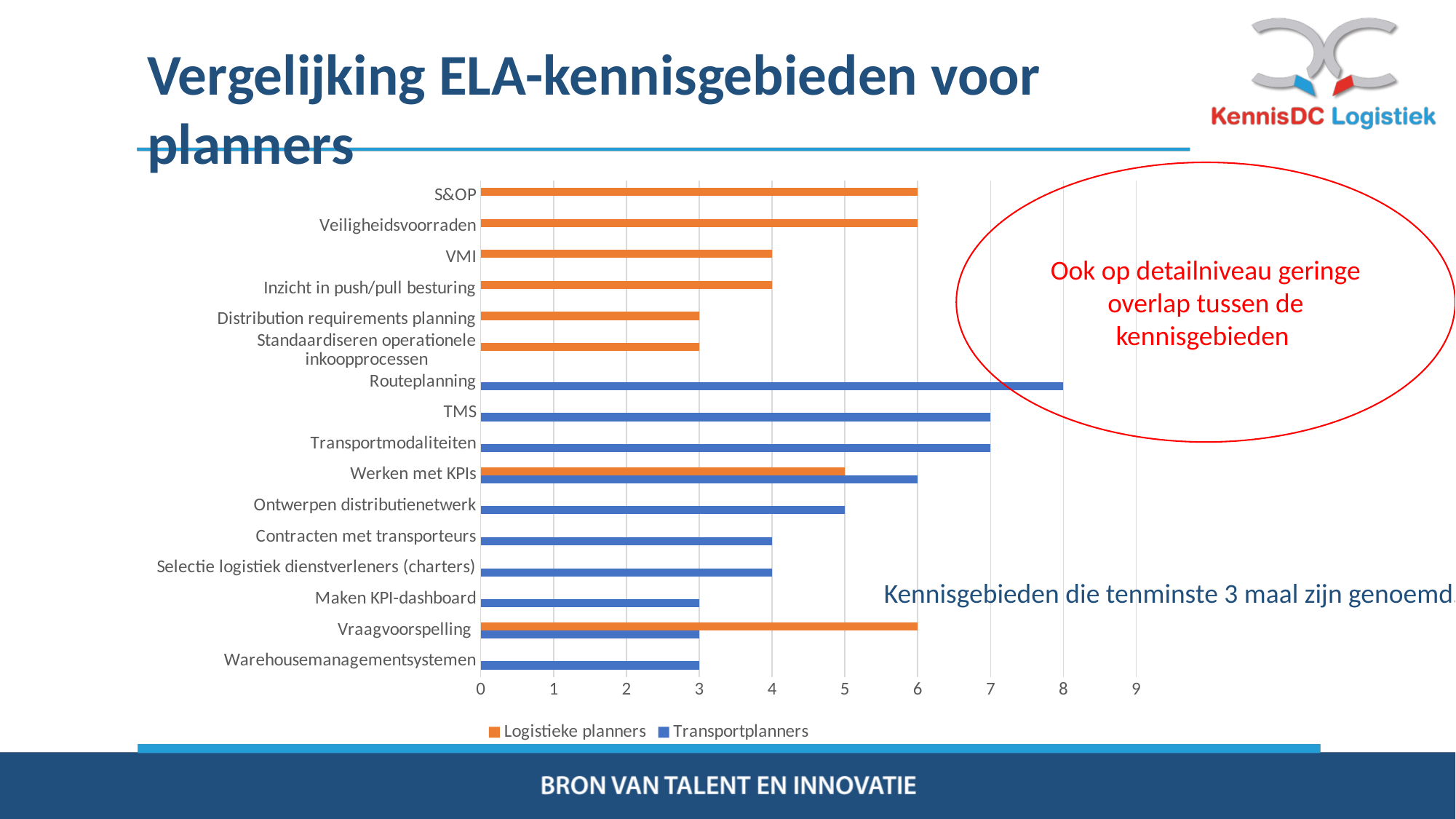
What is the difference between the Logistieke planners value and the Transportplanners value for Vraagvoorspelling? 3 For Werken met KPIs, which series has the larger value: Logistieke planners or Transportplanners? Transportplanners Which colour represents the Logistieke planners series in the legend? Orange What is the value for Vraagvoorspelling for Logistieke planners? 6 What is the value for Maken KPI-dashboard for Transportplanners? 3 What is the value for Routeplanning for Transportplanners? 8 Is the value for TMS for Transportplanners greater or less than 5? greater How many categories (knowledge areas) are plotted on the chart? 16 What is the value for S&OP for Logistieke planners? 6 What kind of chart is shown on the slide? Bar chart Which category has the highest value for Transportplanners? Routeplanning How many series does the legend list? 2